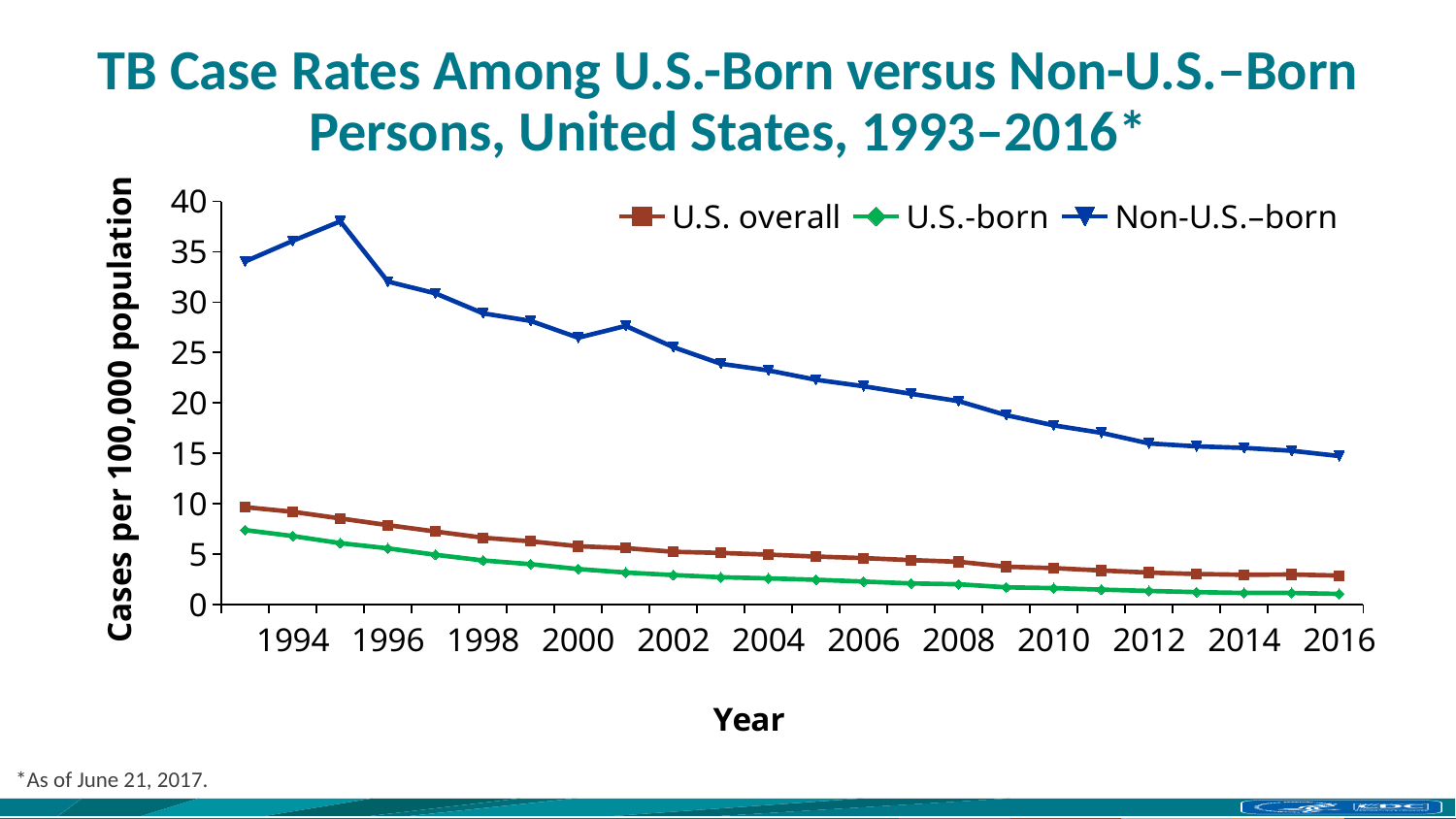
Is the value for Non-U.S.–born in 2016 greater or less than 20? less What is the label of the y axis? Cases per 100,000 population Which series has the lowest case rate across all years? U.S.-born In 2000, which is larger: the U.S. overall rate or the U.S.-born rate? U.S. overall Is the value for Non-U.S.–born in 1995 greater or less than 35? greater How many series does the legend list? 3 Does the Non-U.S.–born case rate generally rise or fall from 1996 to 2016? Fall Which series has the highest case rate across all years? Non-U.S.–born In which year does the Non-U.S.–born series reach its highest value? 1995 What kind of chart is shown on the slide? Line chart Which series are listed in the legend? U.S. overall, U.S.-born, Non-U.S.–born How many years (data points) are plotted for each series? 24